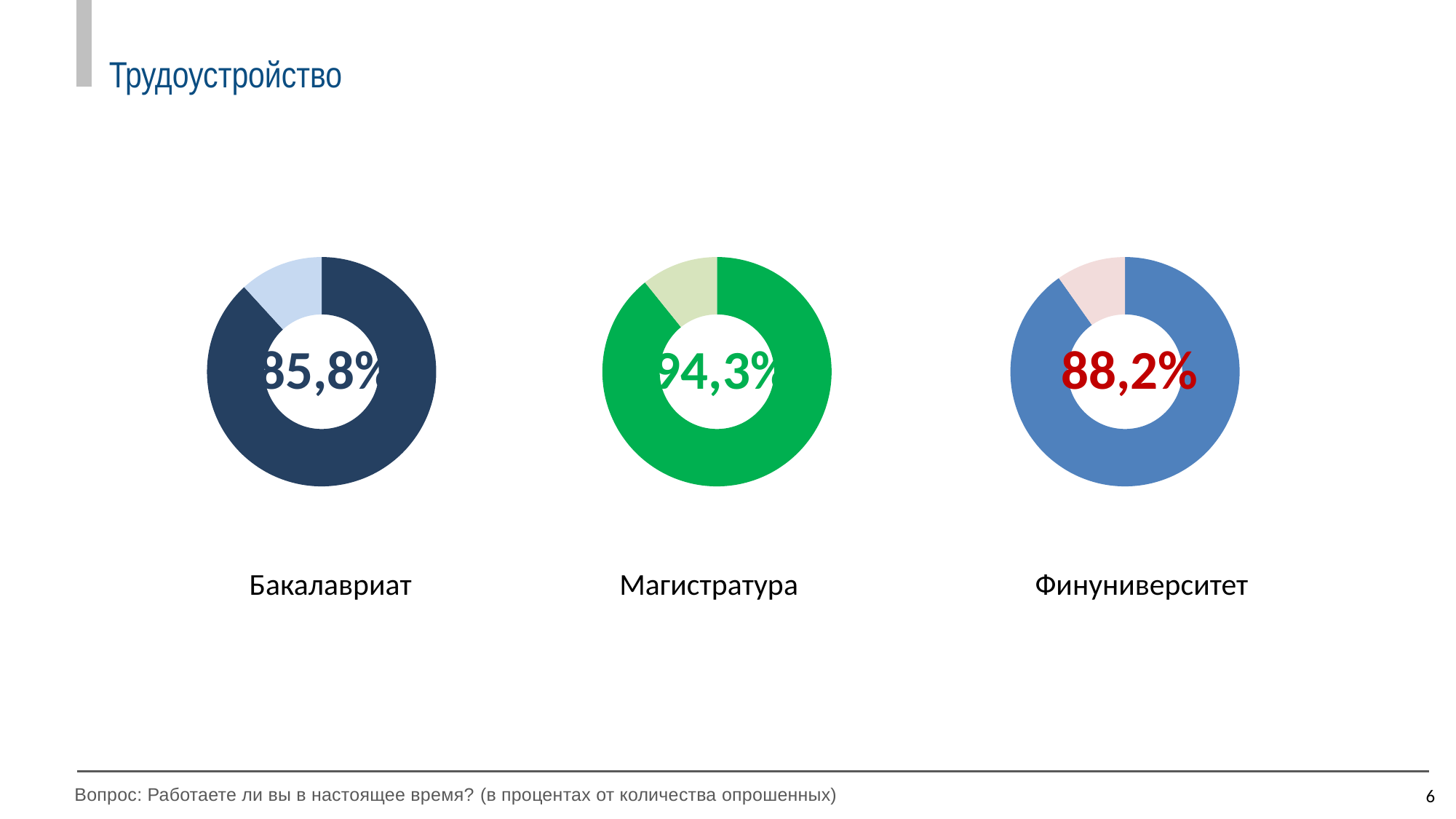
What kind of chart is used for each of the three figures on the slide? Donut (pie) chart What is the value shown in the Магистратура chart? 94,3% What is the difference between the Магистратура value and the Бакалавриат value? 8,5% Which of the three charts shows the lowest percentage? Бакалавриат Is the value in the Бакалавриат chart greater or less than 90%? less Which of the three charts shows the highest percentage? Магистратура What is the difference between the Финуниверситет value and the Бакалавриат value? 2,4% How many donut charts are on the slide? 3 Which is larger, the Финуниверситет value or the Магистратура value? Магистратура What is the value shown in the Бакалавриат chart? 85,8% What is the value shown in the Финуниверситет chart? 88,2% What is the title of the slide containing the three charts? Трудоустройство